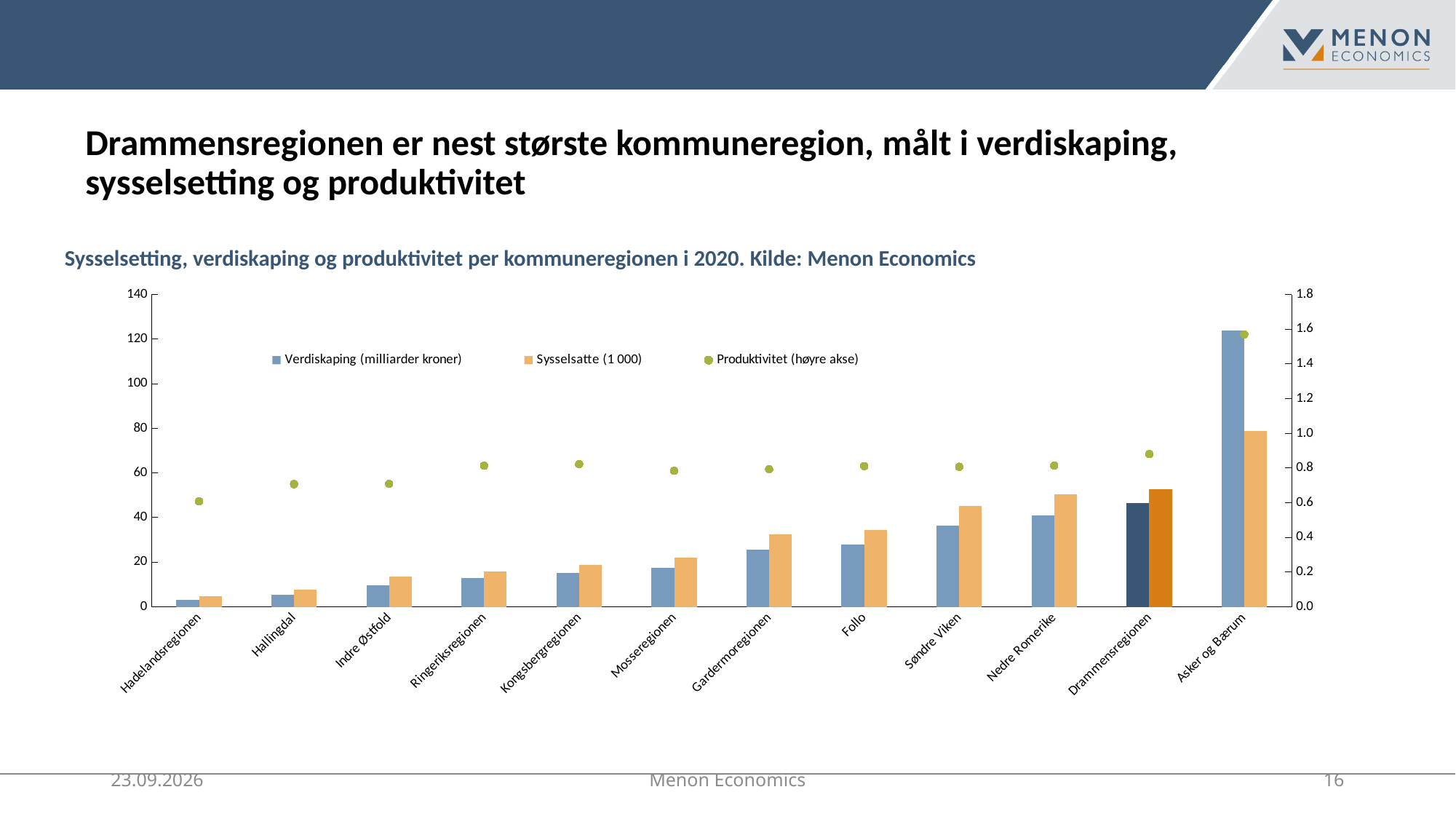
Is the Produktivitet value for Asker og Bærum greater or less than 1.4 on the right axis? greater Which series in the legend is plotted against the right-hand axis? Produktivitet (høyre akse) Which has the larger Sysselsatte (1 000) value, Drammensregionen or Follo? Drammensregionen How many series does the chart legend list? 3 Is the Verdiskaping value for Follo greater or less than 40? less Which region has the highest Verdiskaping (milliarder kroner)? Asker og Bærum How many kommuneregioner (categories) are shown on the x axis of the chart? 12 Which region has the highest Produktivitet (høyre akse)? Asker og Bærum Which region has the lowest Verdiskaping (milliarder kroner)? Hadelandsregionen Is the Verdiskaping value for Asker og Bærum greater or less than 100? greater What kind of chart is used to show Verdiskaping and Sysselsatte? Bar chart